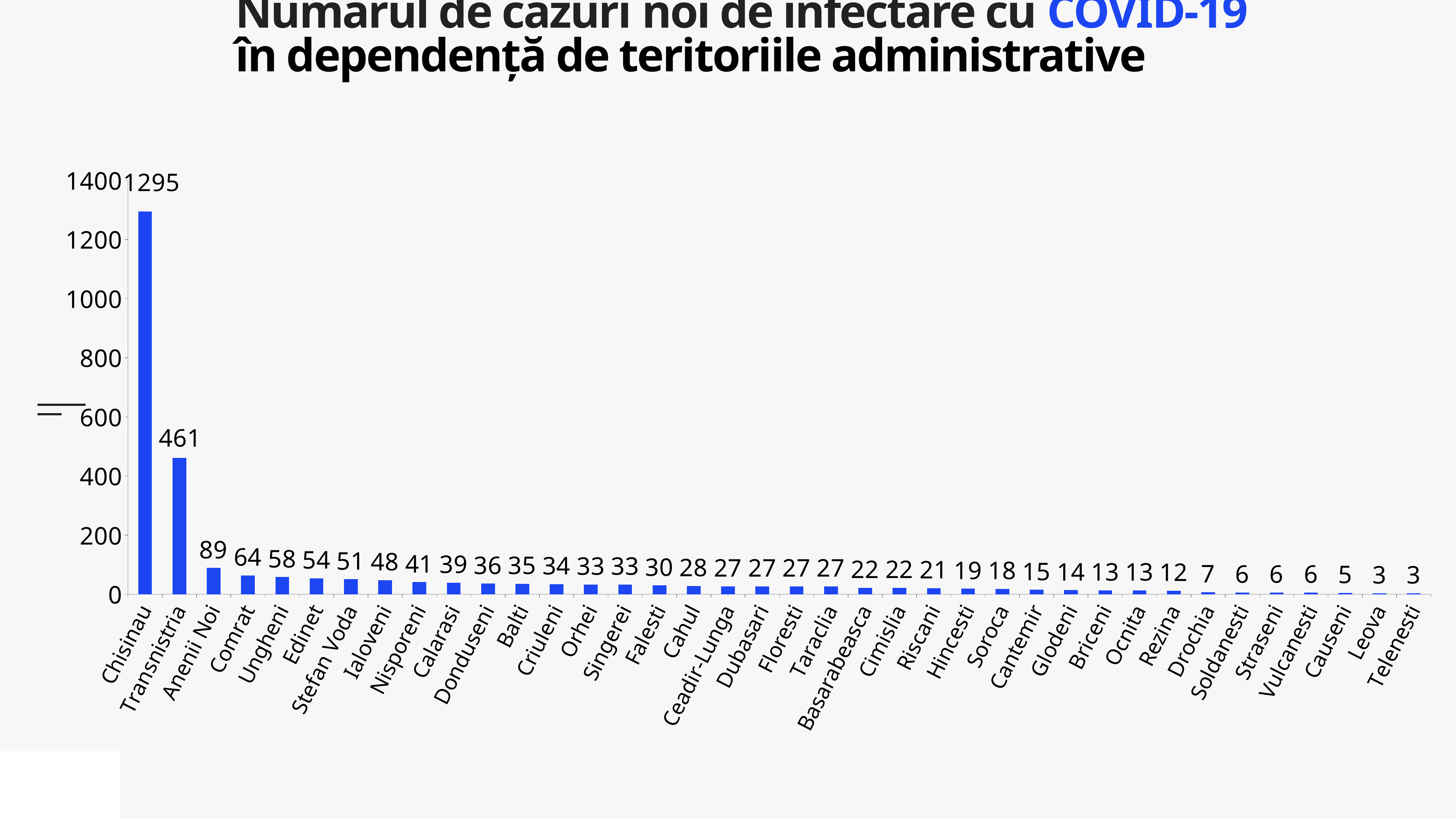
What kind of chart is shown on the slide? bar chart How many territories are shown on the x axis? 38 What is the value shown for Balti? 35 Do the values rise or fall from left to right along the x axis? fall What is the value shown for Transnistria? 461 Which territory has the highest number of new cases? Chisinau What is the value shown for Anenii Noi? 89 What is the difference between the values for Chisinau and Transnistria? 834 Is the value for Transnistria greater or less than 400? greater Which has a larger value, Cahul or Soroca? Cahul What is the difference between the values for Comrat and Ungheni? 6 What is the number of new COVID-19 cases for Chisinau? 1295